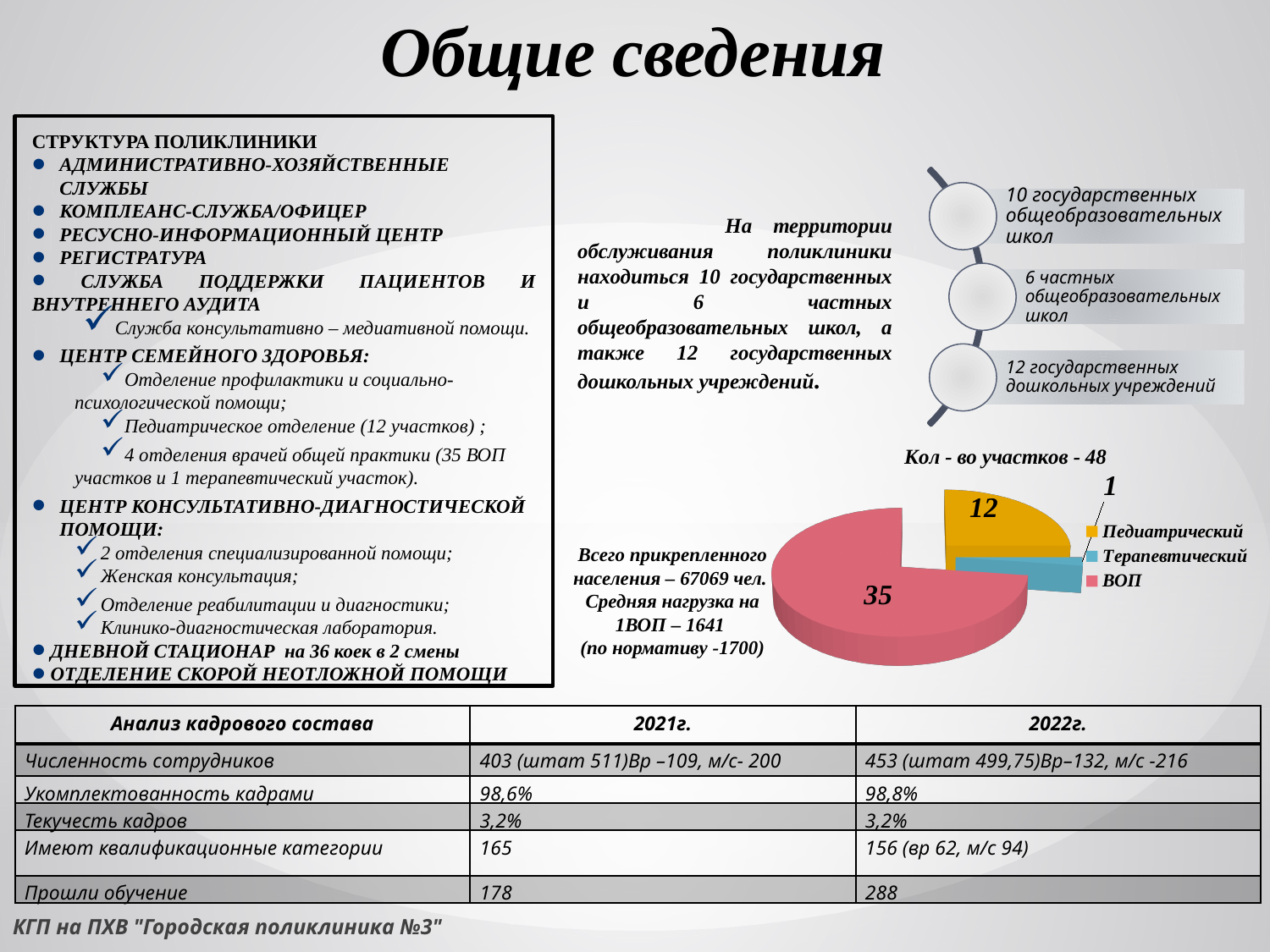
What is the difference between the values for ВОП and Педиатрический in the pie chart? 23 What is the value for ВОП in the pie chart? 35 How many entries does the legend of the pie chart list? 3 What is the total of all slices in the pie chart? 48 What is the value for Педиатрический in the pie chart? 12 Which category has the largest slice in the pie chart? ВОП Which is larger in the pie chart, Педиатрический or Терапевтический? Педиатрический How many slices does the pie chart have? 3 Which category has the smallest slice in the pie chart? Терапевтический What type of chart is shown on the slide? pie chart What is the value for Терапевтический in the pie chart? 1 What is the title of the pie chart? Кол - во участков - 48